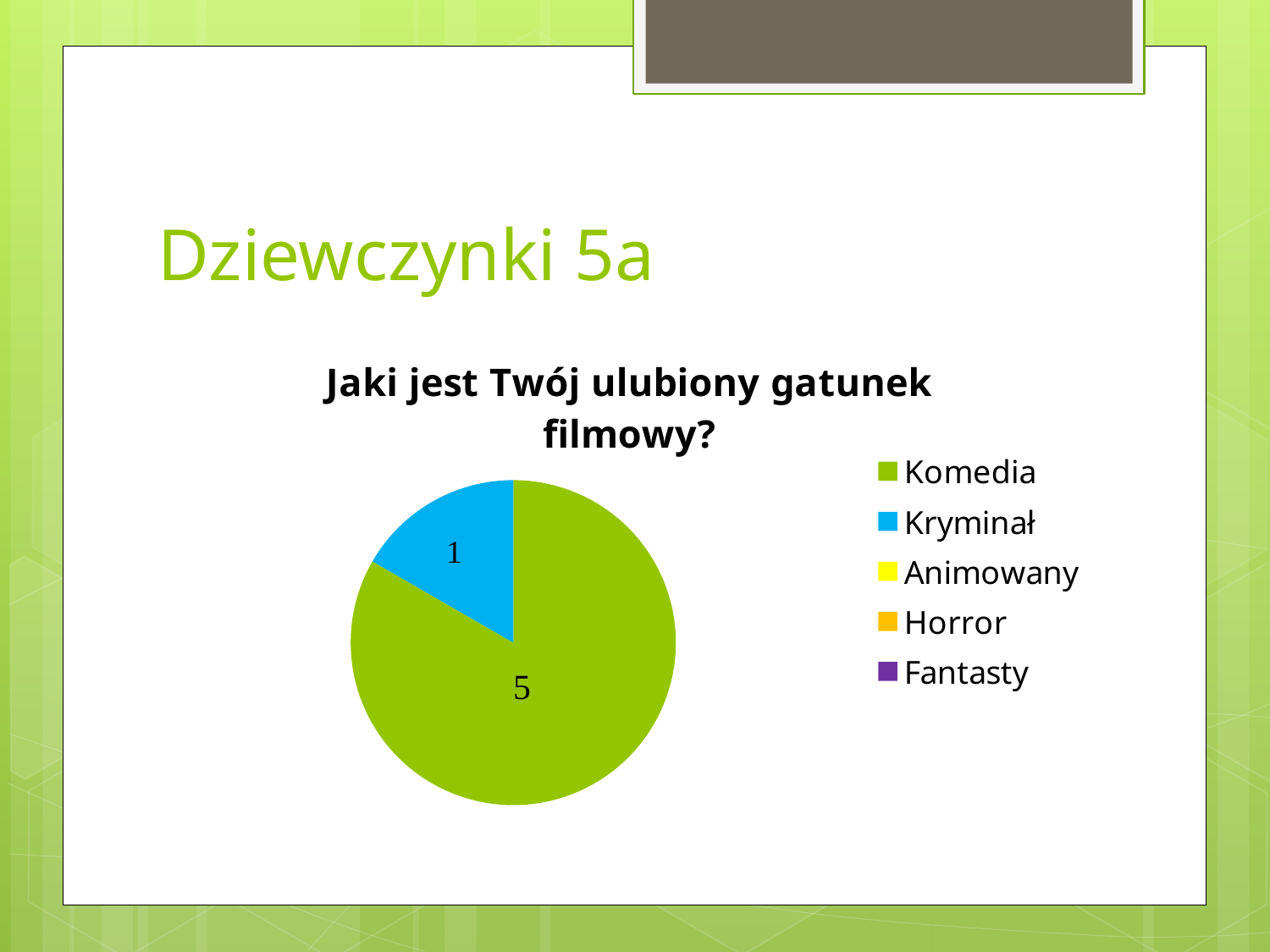
How many slices with data labels are visible in the pie chart? 2 What value is shown for Kryminał? 1 What value is shown for Komedia? 5 Which is larger, the value for Komedia or the value for Kryminał? Komedia Which colour represents Kryminał in the legend? blue What type of chart is shown on the slide? pie chart What is the total of the labelled slice values in the pie chart? 6 How many entries does the chart legend list? 5 What is the difference between the values for Komedia and Kryminał? 4 Which category has the largest slice of the pie? Komedia What is the title of the chart? Jaki jest Twój ulubiony gatunek filmowy?